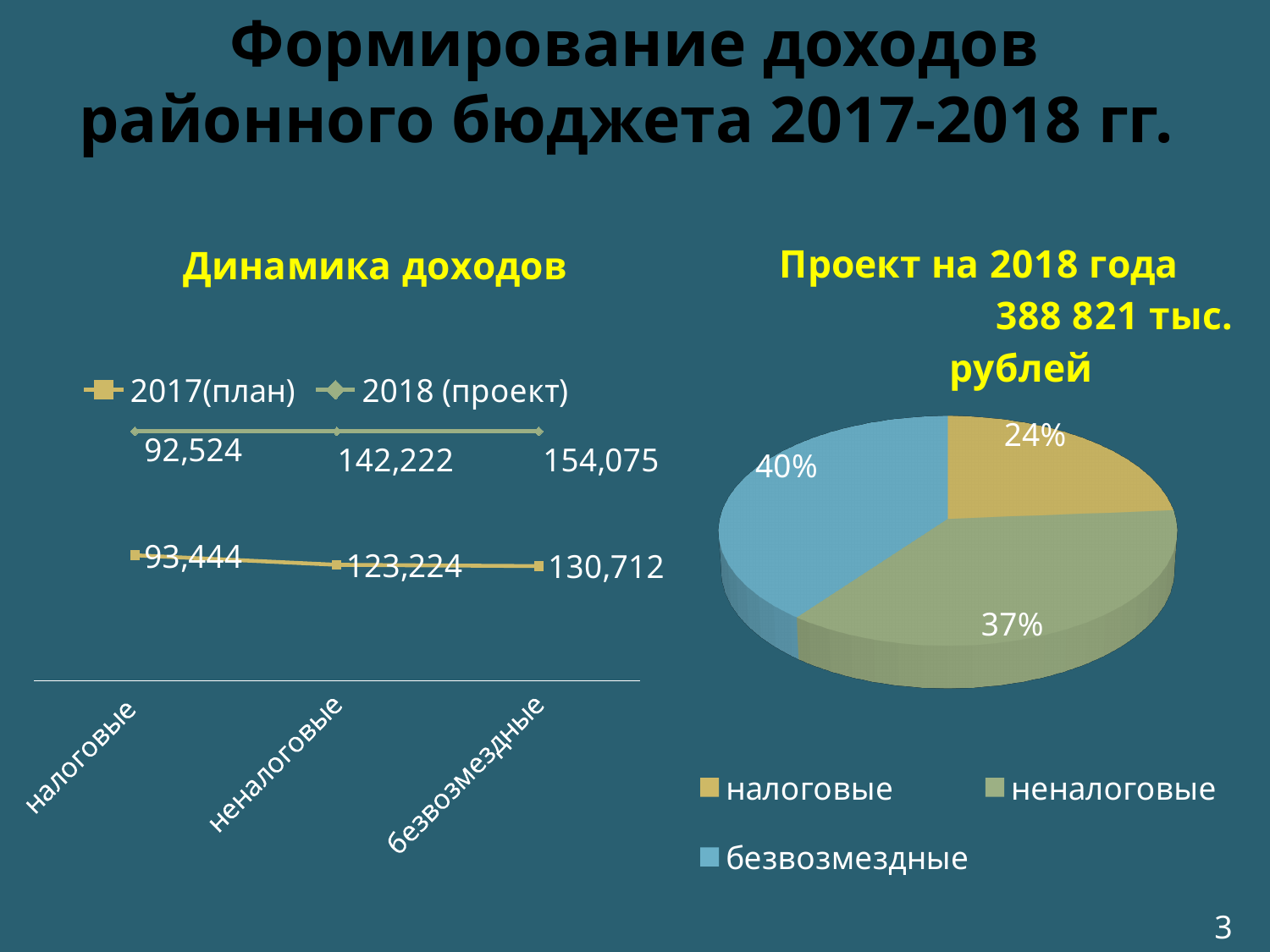
On the 'Проект на 2018 года' pie chart, what share do неналоговые have? 37% On the 'Динамика доходов' chart, what is the 2017(план) value for налоговые? 93,444 On the 'Динамика доходов' chart, what is the 2018 (проект) value for безвозмездные? 154,075 On the 'Динамика доходов' chart, what is the 2017(план) value for безвозмездные? 130,712 On the 'Динамика доходов' chart, how many series does the legend list? 2 On the 'Динамика доходов' chart, which category has the lowest 2017(план) value? налоговые On the 'Динамика доходов' chart, what is the 2018 (проект) value for неналоговые? 142,222 On the 'Динамика доходов' chart, how many categories are shown on the x axis? 3 On the 'Динамика доходов' chart, which category has the highest 2018 (проект) value? безвозмездные On the 'Проект на 2018 года' pie chart, which slice is the largest? безвозмездные On the 'Динамика доходов' chart, what is the difference between the 2018 (проект) and 2017(план) values for неналоговые? 18,998 What kind of chart is 'Проект на 2018 года'? pie chart